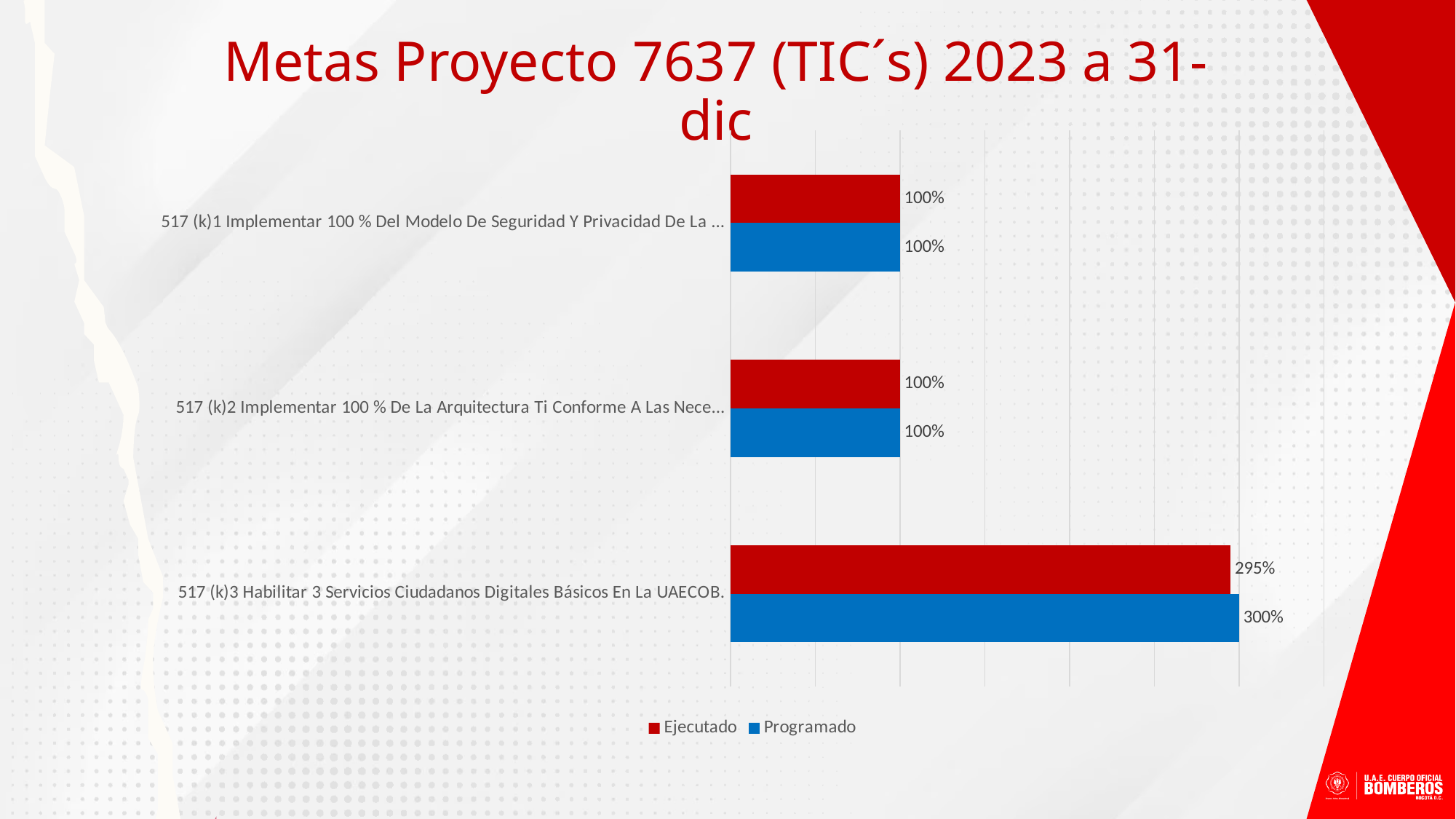
For meta 517 (k)3, which is larger: the Ejecutado value or the Programado value? Programado For meta 517 (k)3, what is the difference between the Programado and Ejecutado values? 5% What is the Programado value for meta 517 (k)2 Implementar 100 % De La Arquitectura Ti? 100% What is the Programado value for meta 517 (k)3 Habilitar 3 Servicios Ciudadanos Digitales Básicos En La UAECOB? 300% What is the Ejecutado value for meta 517 (k)3 Habilitar 3 Servicios Ciudadanos Digitales Básicos En La UAECOB? 295% Which meta has the highest Ejecutado value? 517 (k)3 Habilitar 3 Servicios Ciudadanos Digitales Básicos En La UAECOB. What kind of chart is shown on the slide? Bar chart What is the Ejecutado value for meta 517 (k)1 Implementar 100 % Del Modelo De Seguridad Y Privacidad? 100% Which series is shown in red in the chart? Ejecutado What is the title of the slide containing the chart? Metas Proyecto 7637 (TIC´s) 2023 a 31-dic How many series does the legend list? 2 How many categories (metas) are plotted in the chart? 3